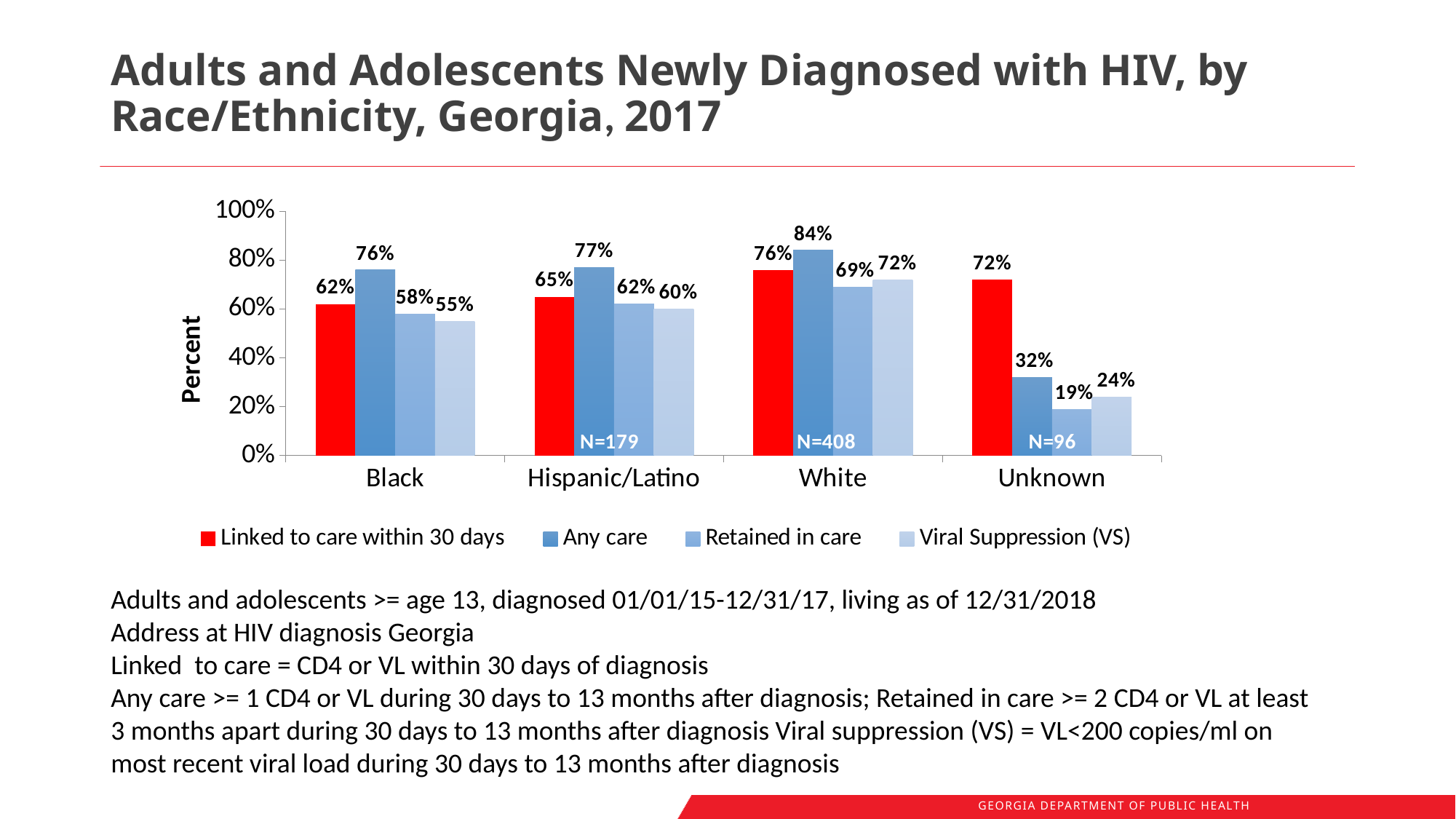
What is the difference between the Any care and Retained in care values for the Black group? 18% Which race/ethnicity group has the highest value for Any care? White How many race/ethnicity categories are shown on the x axis? 4 What is the value for Any care in the White group? 84% What is the value for Viral Suppression (VS) in the Unknown group? 24% How many series does the legend list? 4 What kind of chart is shown on the slide? Bar chart Which is larger for the Hispanic/Latino group: Retained in care or Viral Suppression (VS)? Retained in care Is the value for Linked to care within 30 days in the Unknown group greater or less than 60%? greater What is the N shown for the White group? N=408 Which race/ethnicity group has the lowest value for Retained in care? Unknown What is the value for Linked to care within 30 days in the Hispanic/Latino group? 65%